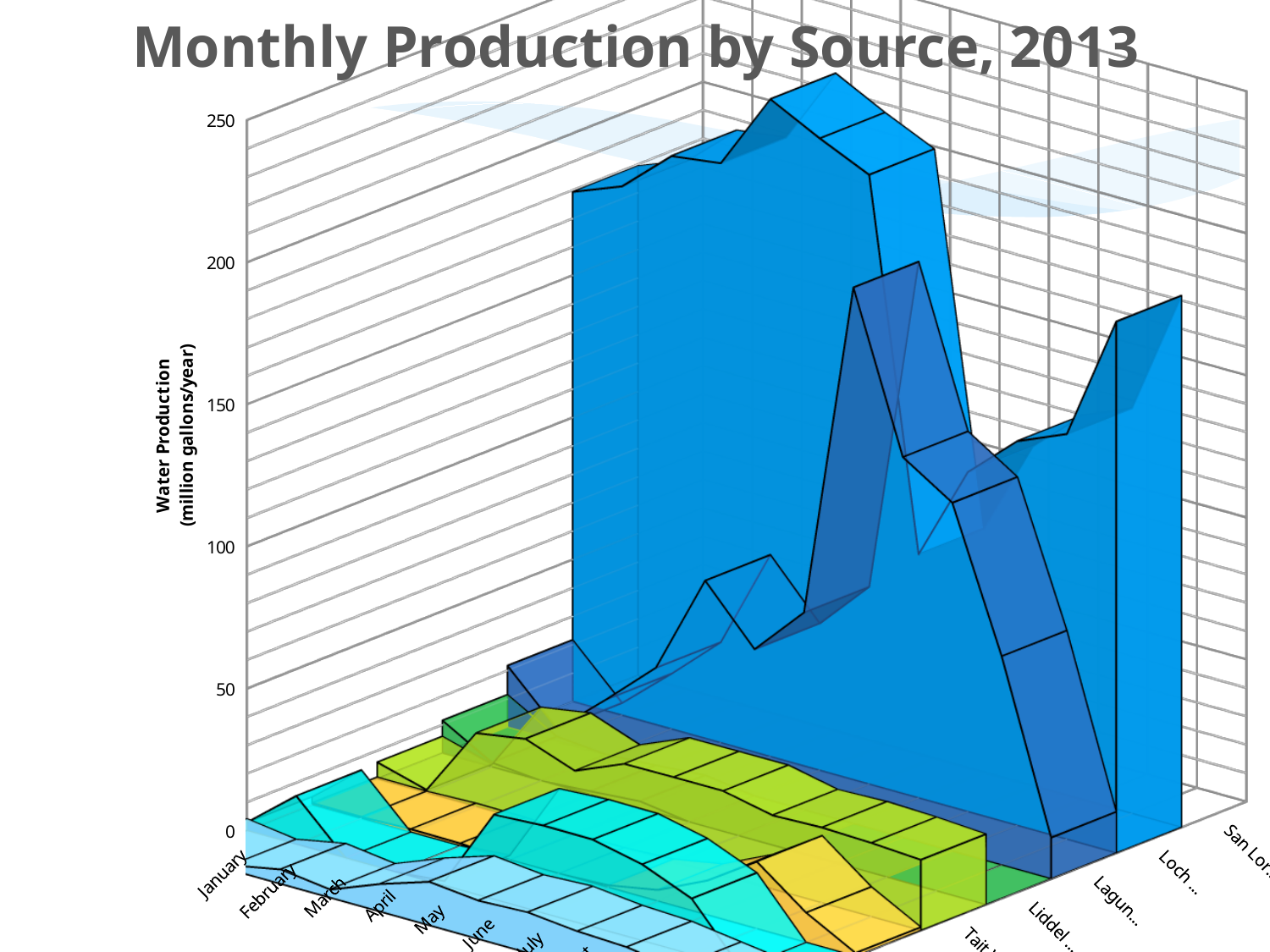
What kind of chart is shown on the slide? 3D area chart What is the label on the vertical axis of the chart? Water Production (million gallons/year) What is the title of the chart? Monthly Production by Source, 2013 What is the first month shown on the horizontal axis of the chart? January